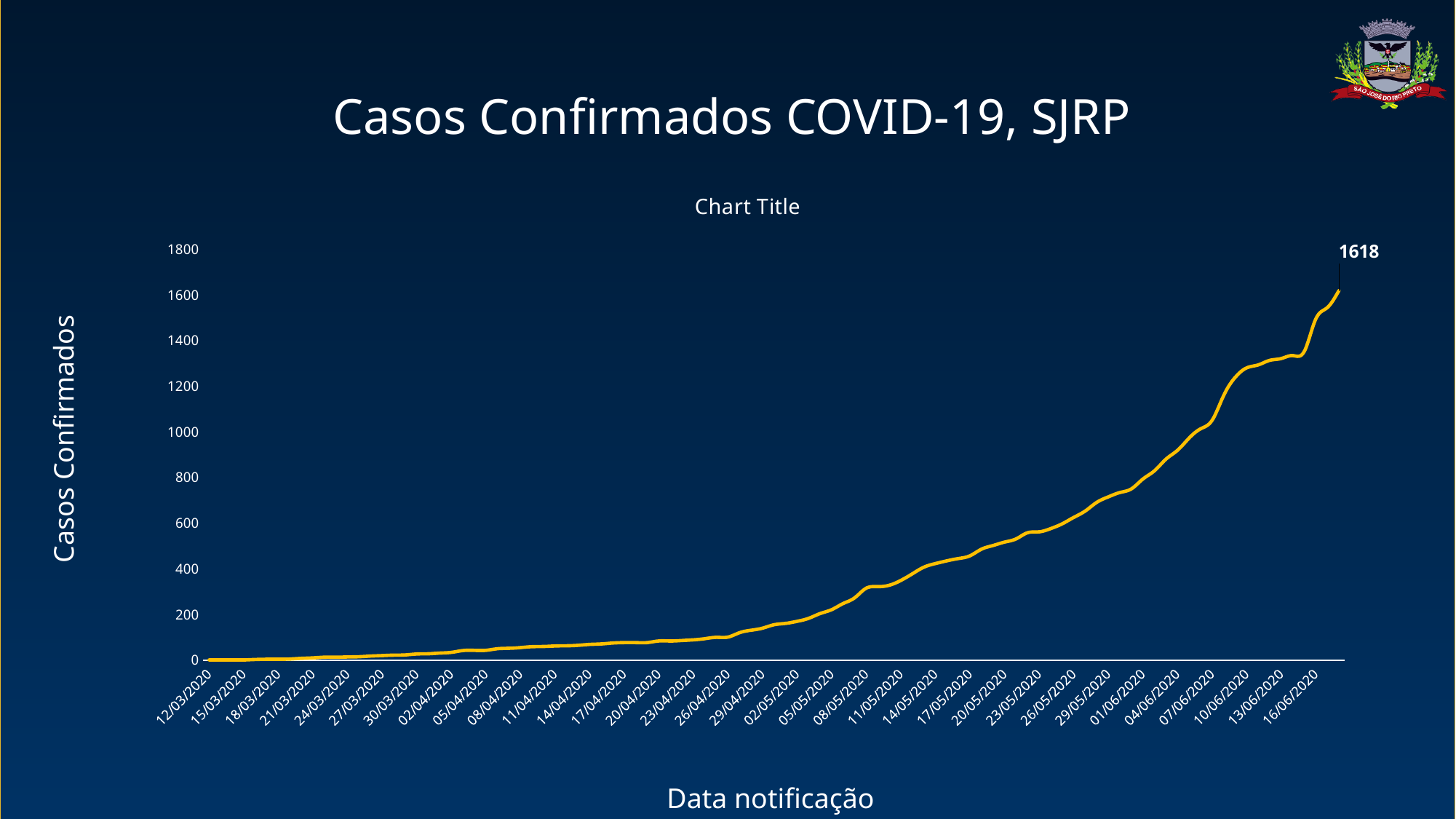
Is the value for 01/06/2020 greater or less than 1000? less What is the label on the y axis? Casos Confirmados What kind of chart is shown on the slide? line chart Is the value for 12/03/2020 greater or less than 200? less Which date has the larger value, 01/06/2020 or 10/06/2020? 10/06/2020 Do the confirmed cases rise or fall along the x axis from 12/03/2020 onward? rise Is the value for 23/05/2020 greater or less than 400? greater What is the label on the x axis? Data notificação What is the highest value reached by the line? 1618 What is the value shown by the data label at the end of the line? 1618 What is the first date shown on the x axis? 12/03/2020